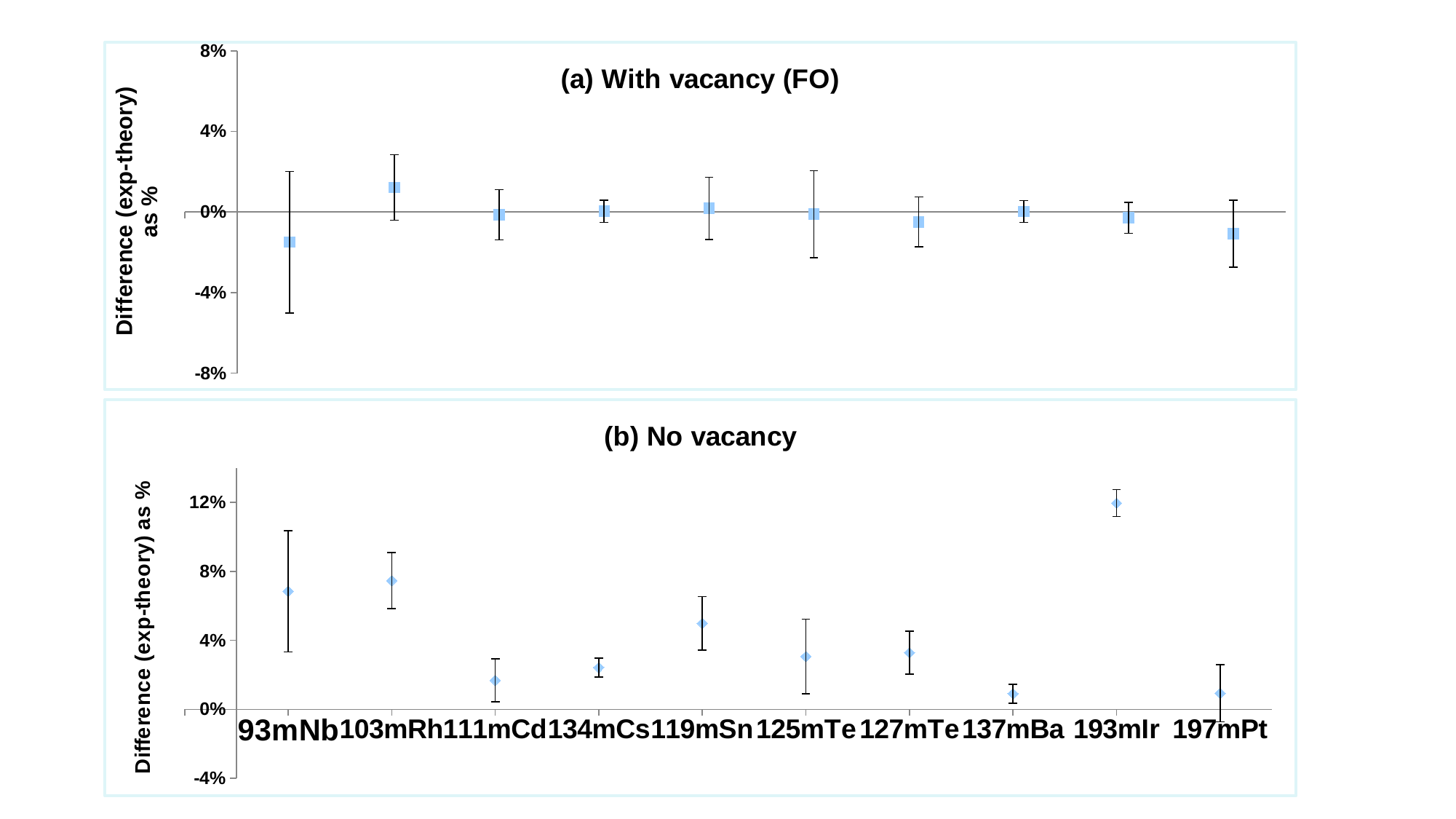
In the chart titled "(b) No vacancy", which isotope has the highest difference value? 193mIr In the chart titled "(a) With vacancy (FO)", which isotope has the highest difference value? 103mRh In the chart titled "(b) No vacancy", how many isotopes are plotted along the x axis? 10 In the chart titled "(a) With vacancy (FO)", is the value for 93mNb greater or less than 0%? less In the chart titled "(b) No vacancy", which has the larger value, 93mNb or 111mCd? 93mNb What kind of chart is the chart titled "(b) No vacancy"? Scatter chart with error bars In the chart titled "(b) No vacancy", which has the larger value, 119mSn or 125mTe? 119mSn In the chart titled "(b) No vacancy", is the value for 93mNb greater or less than 4%? greater In the chart titled "(b) No vacancy", is the value for 193mIr greater or less than 8%? greater What is the title of the bottom chart? (b) No vacancy What is the title of the top chart? (a) With vacancy (FO)